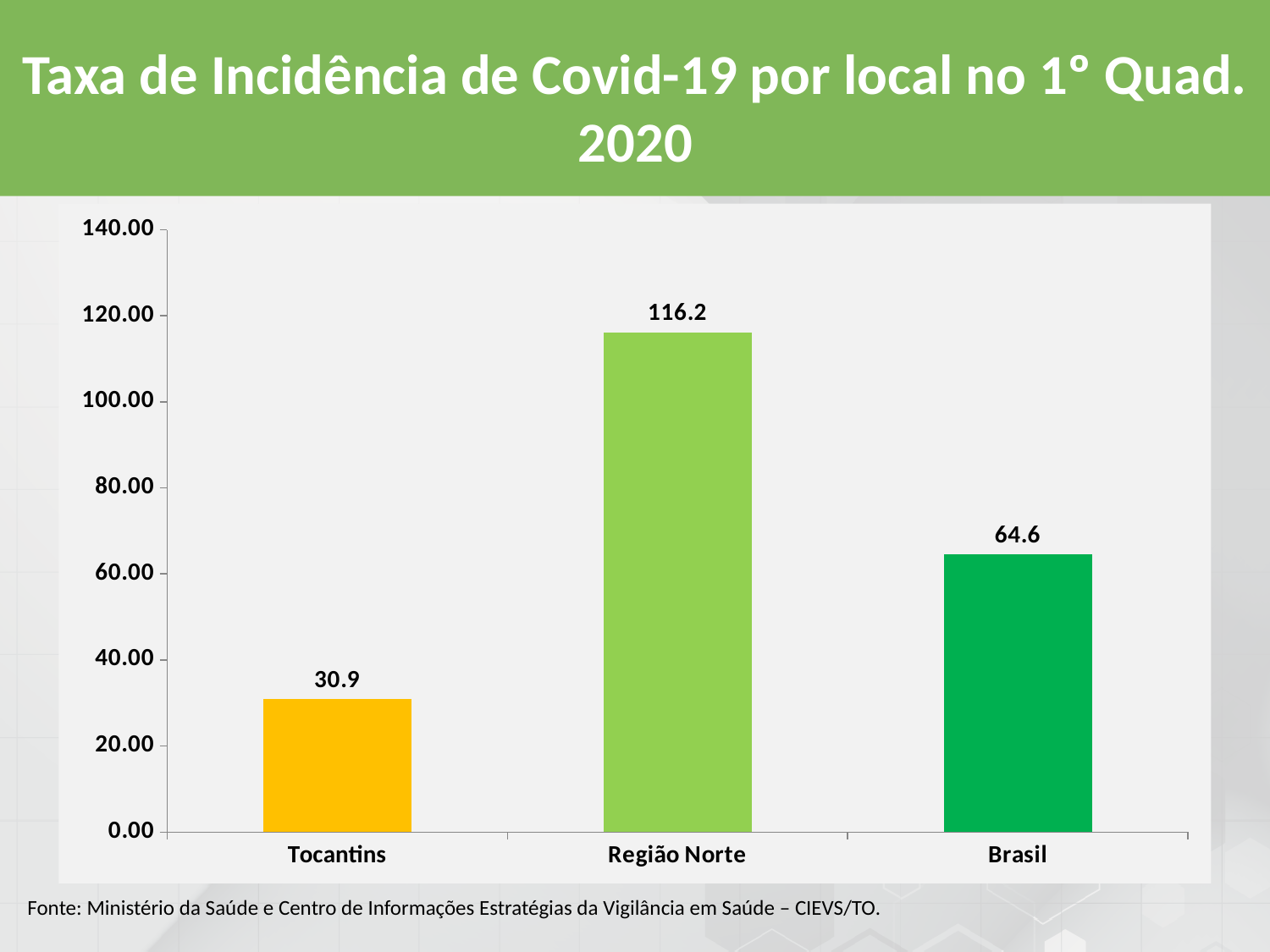
Which location has the highest incidence rate? Região Norte What is the difference between the values for Brasil and Tocantins? 33.7 Which location has the lowest incidence rate? Tocantins What is the Covid-19 incidence rate shown for Tocantins? 30.9 How many locations are shown on the chart? 3 What is the title of the slide? Taxa de Incidência de Covid-19 por local no 1° Quad. 2020 What is the difference between the values for Região Norte and Brasil? 51.6 Is the value for Região Norte greater or less than 100.00? greater What is the value shown for Região Norte? 116.2 Which is larger, the value for Brasil or the value for Tocantins? Brasil What is the value shown for Brasil? 64.6 What kind of chart is shown on the slide? Bar chart